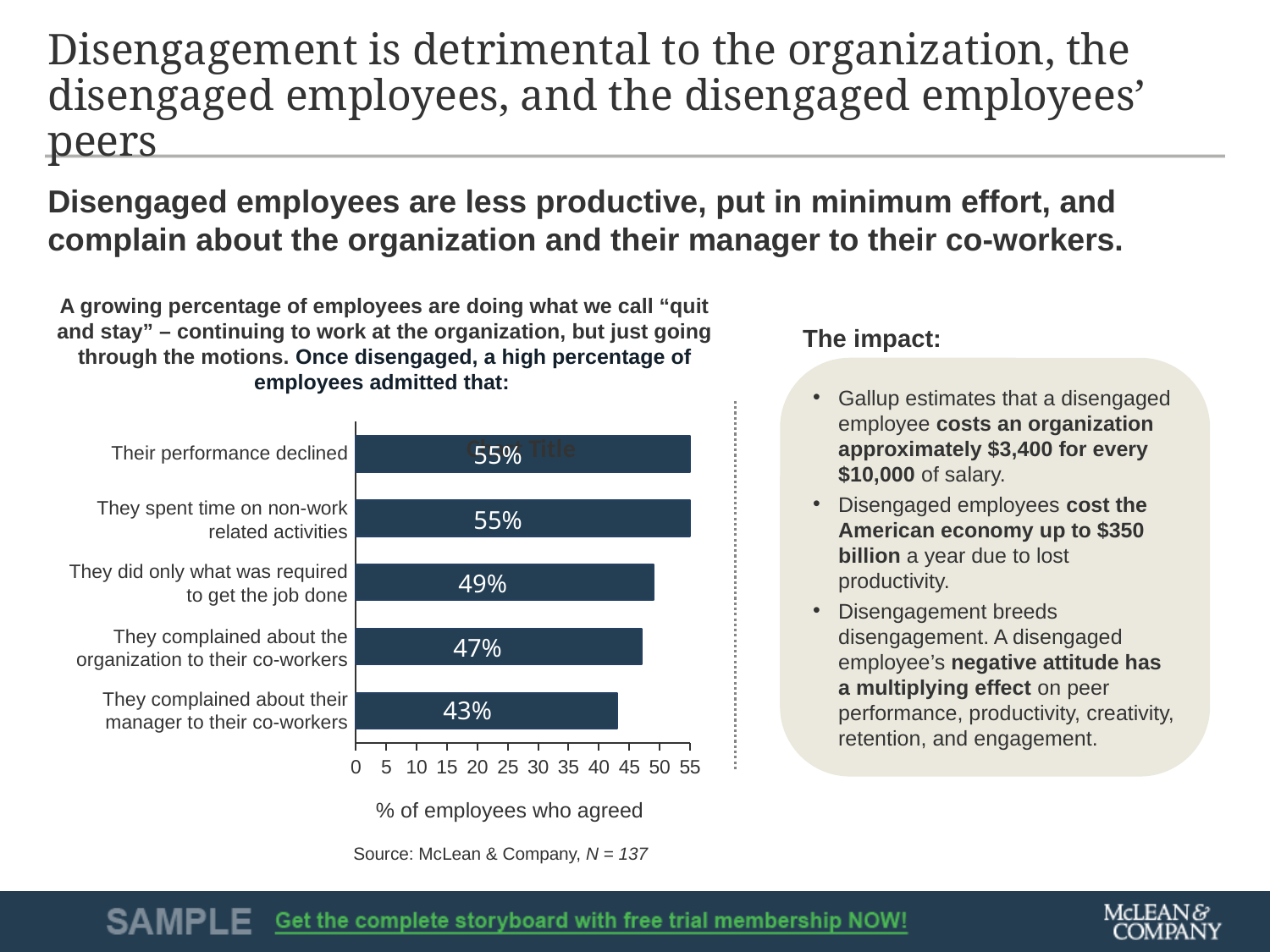
Which is larger: the percentage who did only what was required to get the job done, or the percentage who complained about their manager to their co-workers? They did only what was required to get the job done What percentage of employees admitted they complained about their manager to their co-workers? 43% What percentage of employees admitted they spent time on non-work related activities? 55% What type of chart is used to show the percentage of employees who agreed? Bar chart What percentage of employees admitted they did only what was required to get the job done? 49% What percentage of employees admitted that their performance declined? 55% What is the difference between the percentage who did only what was required and the percentage who complained about the organization to their co-workers? 2% What percentage of employees admitted they complained about the organization to their co-workers? 47% Which category has the lowest percentage of employees who agreed? They complained about their manager to their co-workers What is the difference between the percentage who said their performance declined and the percentage who complained about their manager to their co-workers? 12% What is the label on the horizontal axis of the chart? % of employees who agreed How many categories are shown in the bar chart? 5